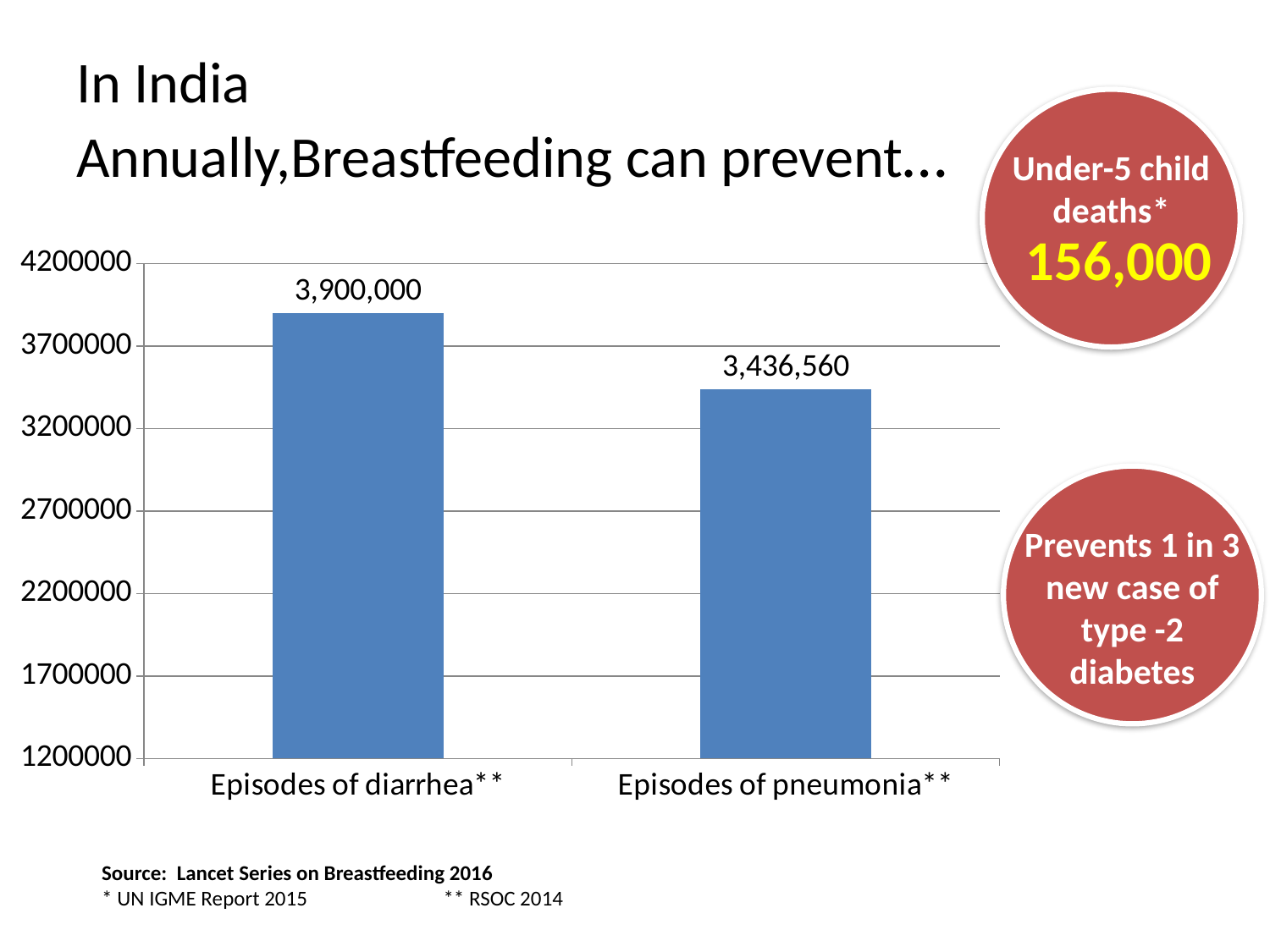
What kind of chart is shown on the slide? bar chart How many categories are shown in the chart? 2 Is the value for Episodes of diarrhea** greater or less than 3700000? greater What is the highest value shown on the vertical axis of the chart? 4200000 Is the value for Episodes of pneumonia** greater or less than 3700000? less Which is larger, the value for Episodes of diarrhea** or Episodes of pneumonia**? Episodes of diarrhea** Which category has the highest value? Episodes of diarrhea** What value is shown for Episodes of diarrhea**? 3,900,000 What value is shown for Episodes of pneumonia**? 3,436,560 Which category has the lowest value? Episodes of pneumonia** What is the lowest value shown on the vertical axis of the chart? 1200000 What is the difference between the values for Episodes of diarrhea** and Episodes of pneumonia**? 463,440